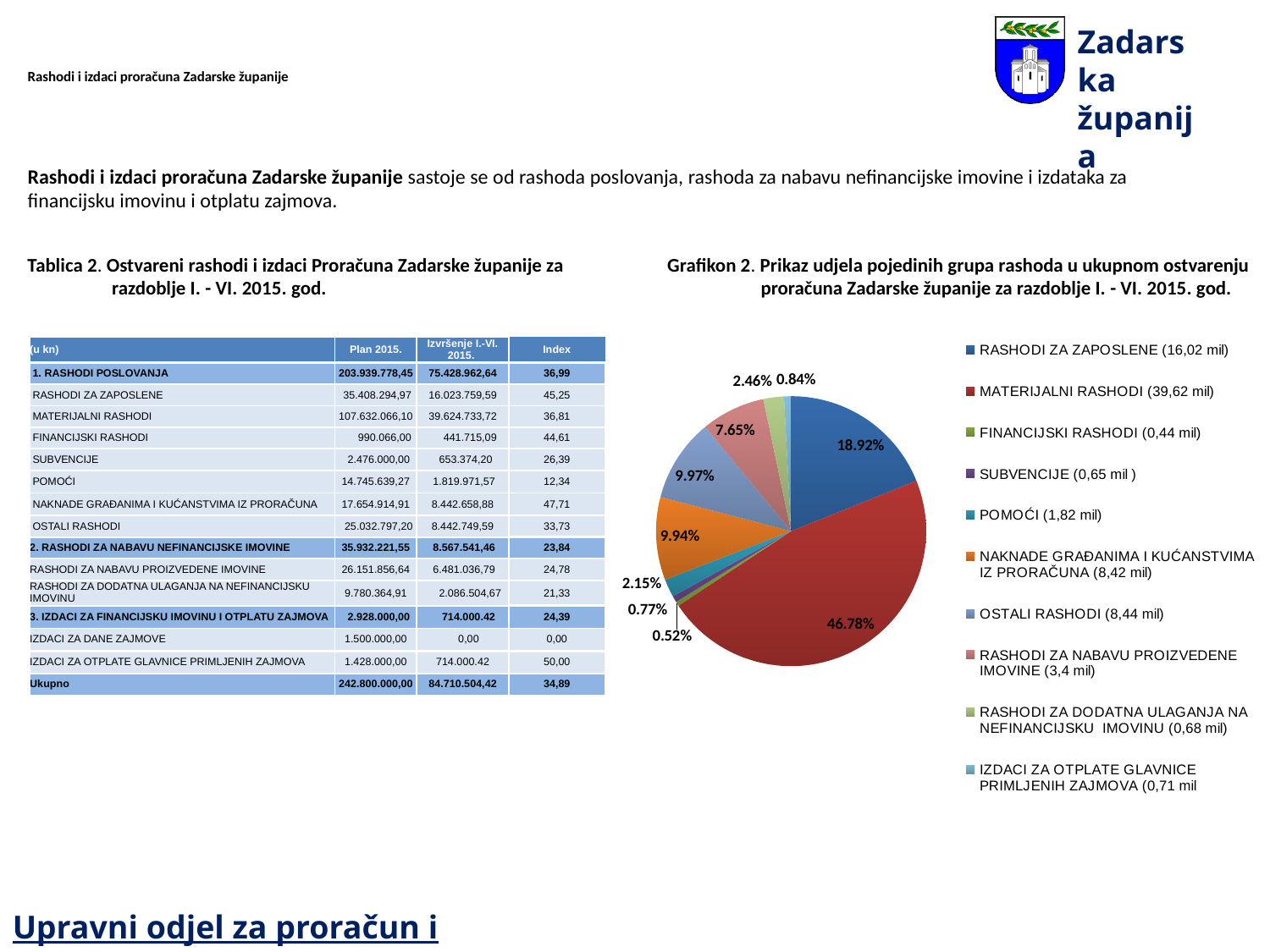
What kind of chart is Grafikon 2 on the slide? pie chart In the pie chart (Grafikon 2), what share is shown for RASHODI ZA NABAVU PROIZVEDENE IMOVINE? 7.65% In the pie chart (Grafikon 2), which share is larger: RASHODI ZA ZAPOSLENE or OSTALI RASHODI? RASHODI ZA ZAPOSLENE In the pie chart (Grafikon 2), what share is shown for MATERIJALNI RASHODI? 46.78% In the pie chart (Grafikon 2), what share is shown for RASHODI ZA ZAPOSLENE? 18.92% In the pie chart (Grafikon 2), what is the difference in percentage points between the shares of MATERIJALNI RASHODI and RASHODI ZA ZAPOSLENE? 27.86 How many slices does the pie chart (Grafikon 2) have? 10 In the pie chart (Grafikon 2), which category has the smallest share? FINANCIJSKI RASHODI In the pie chart (Grafikon 2), what share is shown for POMOĆI? 2.15% In the pie chart (Grafikon 2), what colour is the slice for MATERIJALNI RASHODI? red How many entries does the legend of the pie chart (Grafikon 2) list? 10 In the pie chart (Grafikon 2), which category has the largest share? MATERIJALNI RASHODI